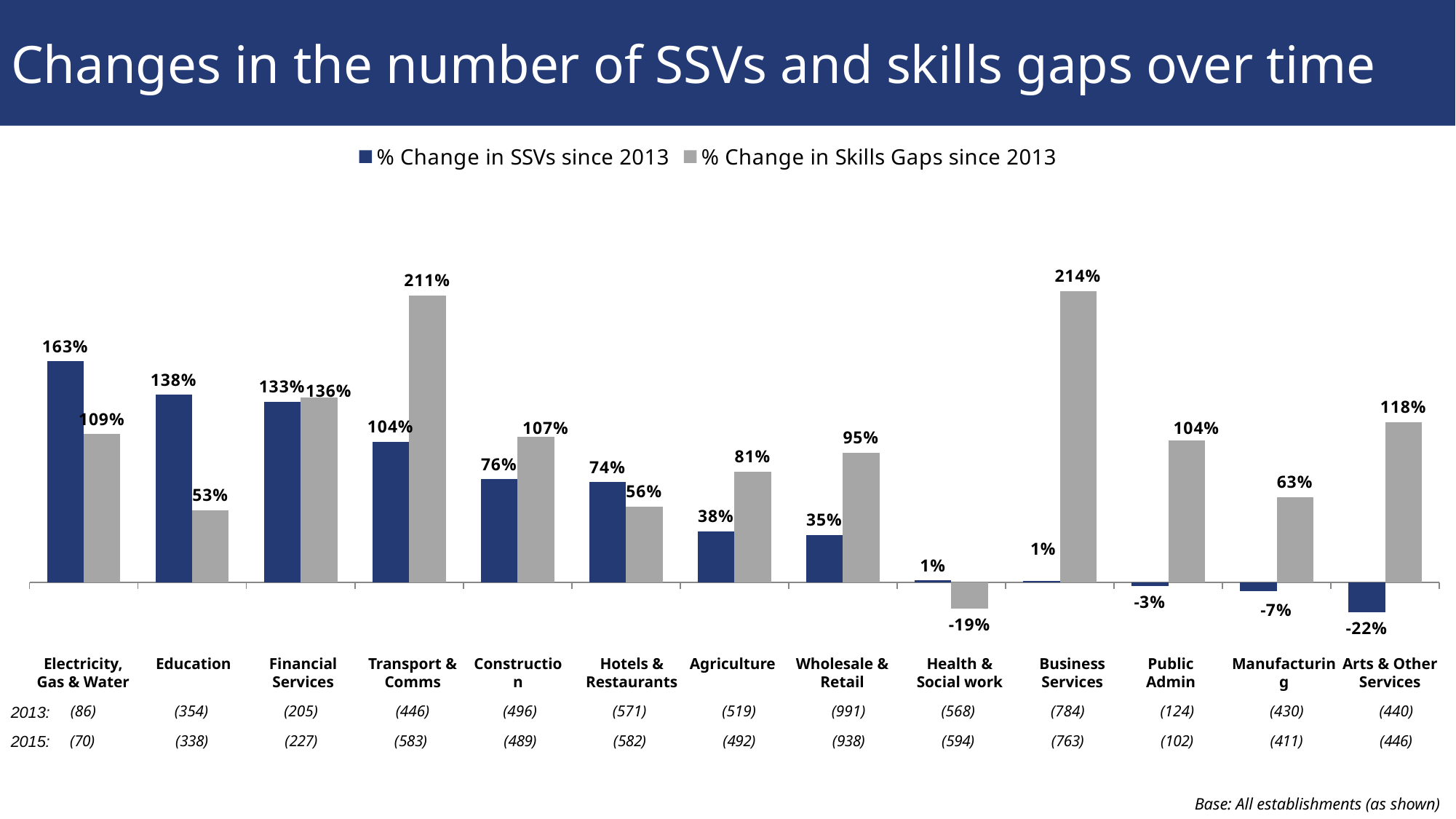
What is the % change in Skills Gaps since 2013 for Transport & Comms? 211% What colour represents the % Change in SSVs since 2013 series? Dark blue Which sector has the highest % change in SSVs since 2013? Electricity, Gas & Water Which sector has the highest % change in Skills Gaps since 2013? Business Services What is the % change in Skills Gaps since 2013 for Manufacturing? 63% For Construction, which is larger: the % change in SSVs or the % change in Skills Gaps since 2013? % Change in Skills Gaps since 2013 What is the difference between the % change in SSVs and the % change in Skills Gaps for Electricity, Gas & Water? 54 percentage points How many sectors are shown on the chart? 13 What is the % change in SSVs since 2013 for Education? 138% How many series does the legend list? 2 Which sector has the lowest % change in SSVs since 2013? Arts & Other Services What kind of chart is shown on the slide? Bar chart